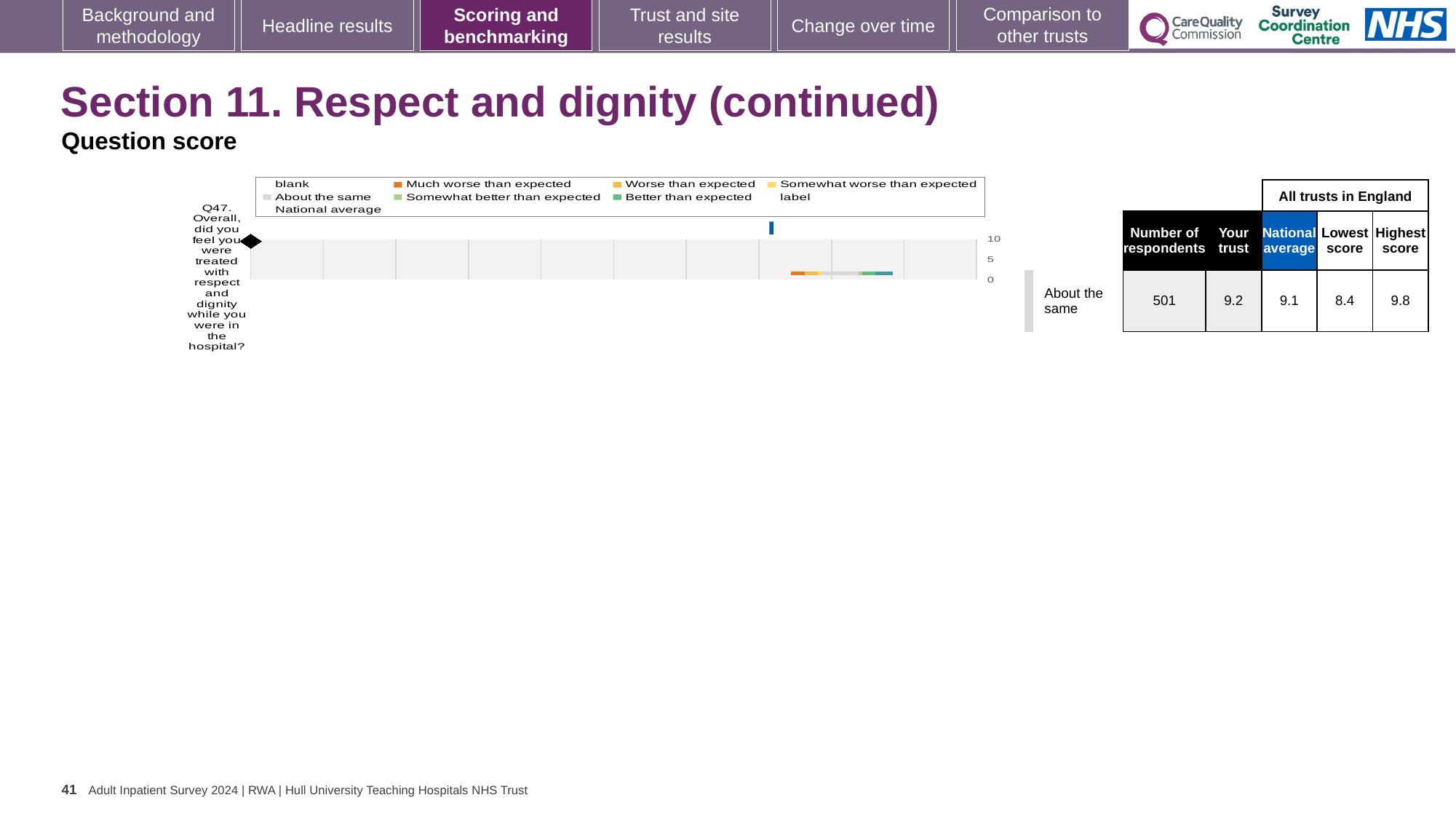
What is the national average score for Q47? 9.1 Which is larger for Q47, the 'Your trust' score or the national average? Your trust What is the lowest score among all trusts in England for Q47? 8.4 What is the 'Your trust' score for Q47? 9.2 How many questions are plotted on the chart? 1 What is the highest score among all trusts in England for Q47? 9.8 What kind of chart is shown on the slide? bar chart Which question is plotted on the chart? Q47. Overall, did you feel you were treated with respect and dignity while you were in the hospital? What is the difference between the highest and lowest scores for Q47 among all trusts in England? 1.4 What is the highest value shown on the chart's axis? 10 What benchmark category is Q47 assigned to? About the same How many respondents answered Q47? 501